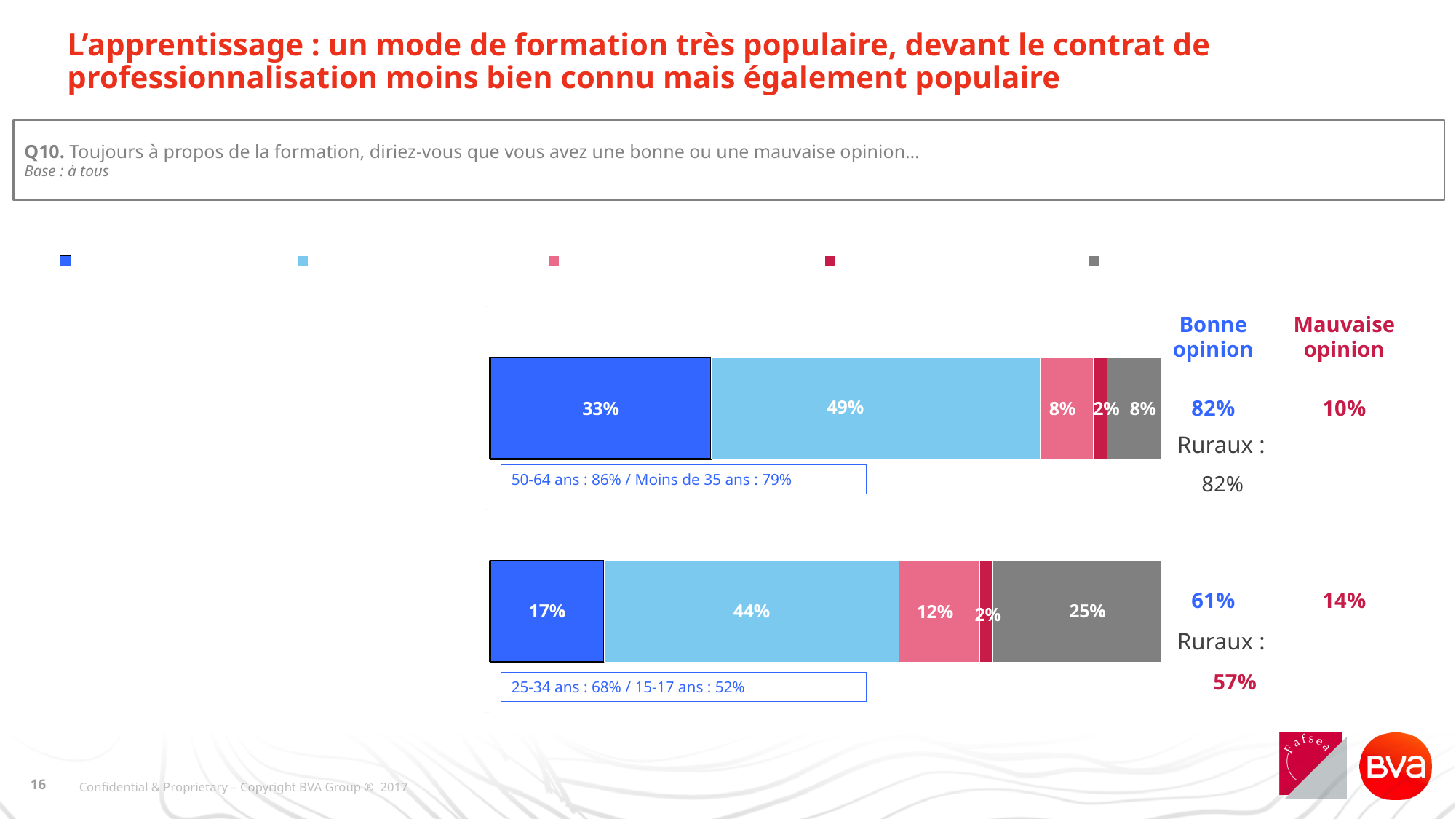
What is the difference between the dark blue segment of the top bar and the dark blue segment of the bottom bar? 16 percentage points How many series markers does the legend show? 5 What kind of chart is shown on the slide? Stacked bar chart What is the value of the grey segment in the bottom bar? 25% What is the value of the light blue segment in the bottom bar? 44% Is the light blue segment larger in the top bar or the bottom bar? Top bar What is the combined total of the dark blue and light blue segments in the bottom bar? 61% What is the value of the pink segment in the top bar? 8% What is the value of the dark blue segment in the top bar? 33% Which segment is the smallest in the bottom bar? Dark red (2%) Which segment is the largest in the top bar? Light blue (49%) How many bars does the chart contain? 2